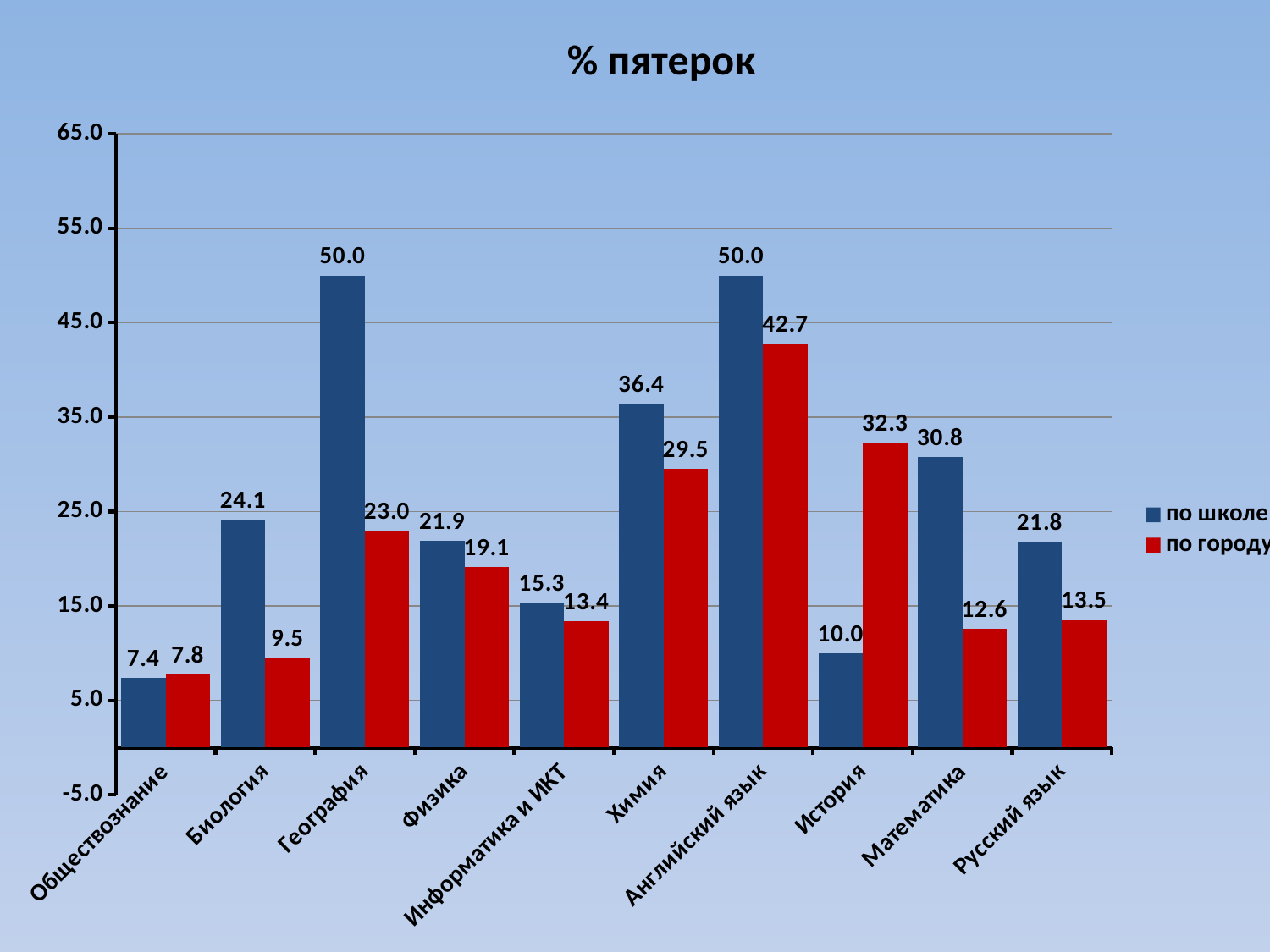
How many categories are shown on the x axis? 10 Which category has the lowest value for "по школе"? Обществознание Which is larger for История: the "по школе" value or the "по городу" value? по городу How many series does the legend list? 2 Is the "по школе" value for Химия greater or less than 35.0? greater What is the title of the chart? % пятерок What is the difference between the "по школе" and "по городу" values for География? 27.0 What is the value for "по школе" for Математика? 30.8 What kind of chart is shown on the slide? bar chart What is the value for "по школе" for Биология? 24.1 What is the value for "по городу" for История? 32.3 Which category has the highest value for "по городу"? Английский язык